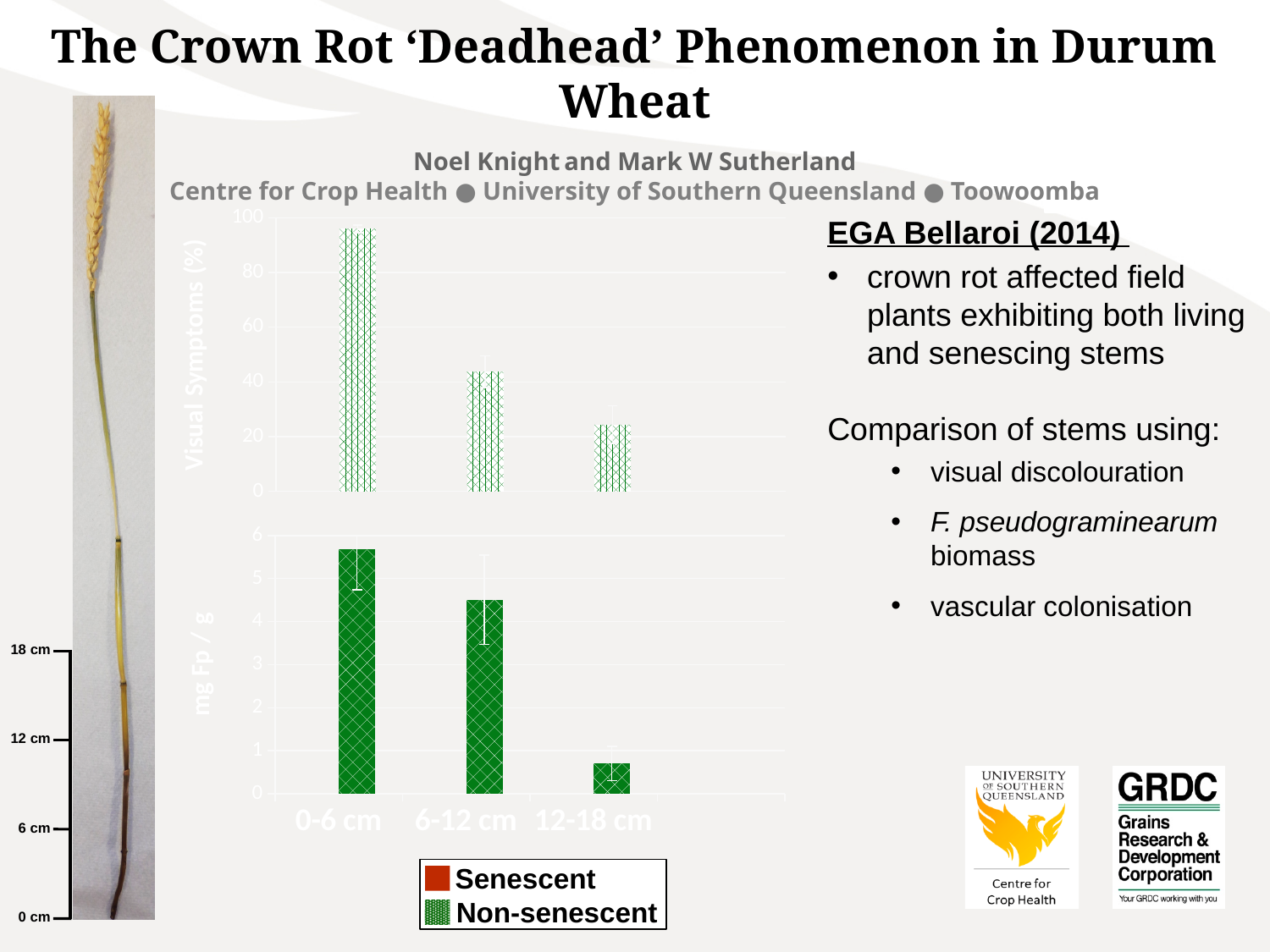
How many series does the legend list? 2 How many stem section categories are shown on the x axis of the charts? 3 What kind of chart is the top chart (Visual Symptoms (%))? bar chart In the bottom chart (mg Fp / g), which is larger, the value for 6-12 cm or the value for 12-18 cm? 6-12 cm In the bottom chart (mg Fp / g), is the value for 0-6 cm greater or less than 5? greater In the top chart (Visual Symptoms (%)), is the value for 12-18 cm greater or less than 40? less In the top chart (Visual Symptoms (%)), which stem section has the lowest value? 12-18 cm In the bottom chart (mg Fp / g), which stem section has the highest value? 0-6 cm In the top chart (Visual Symptoms (%)), which stem section has the highest value? 0-6 cm In the top chart (Visual Symptoms (%)), is the value for 0-6 cm greater or less than 80? greater In the top chart (Visual Symptoms (%)), do the values rise or fall from 0-6 cm to 12-18 cm? fall